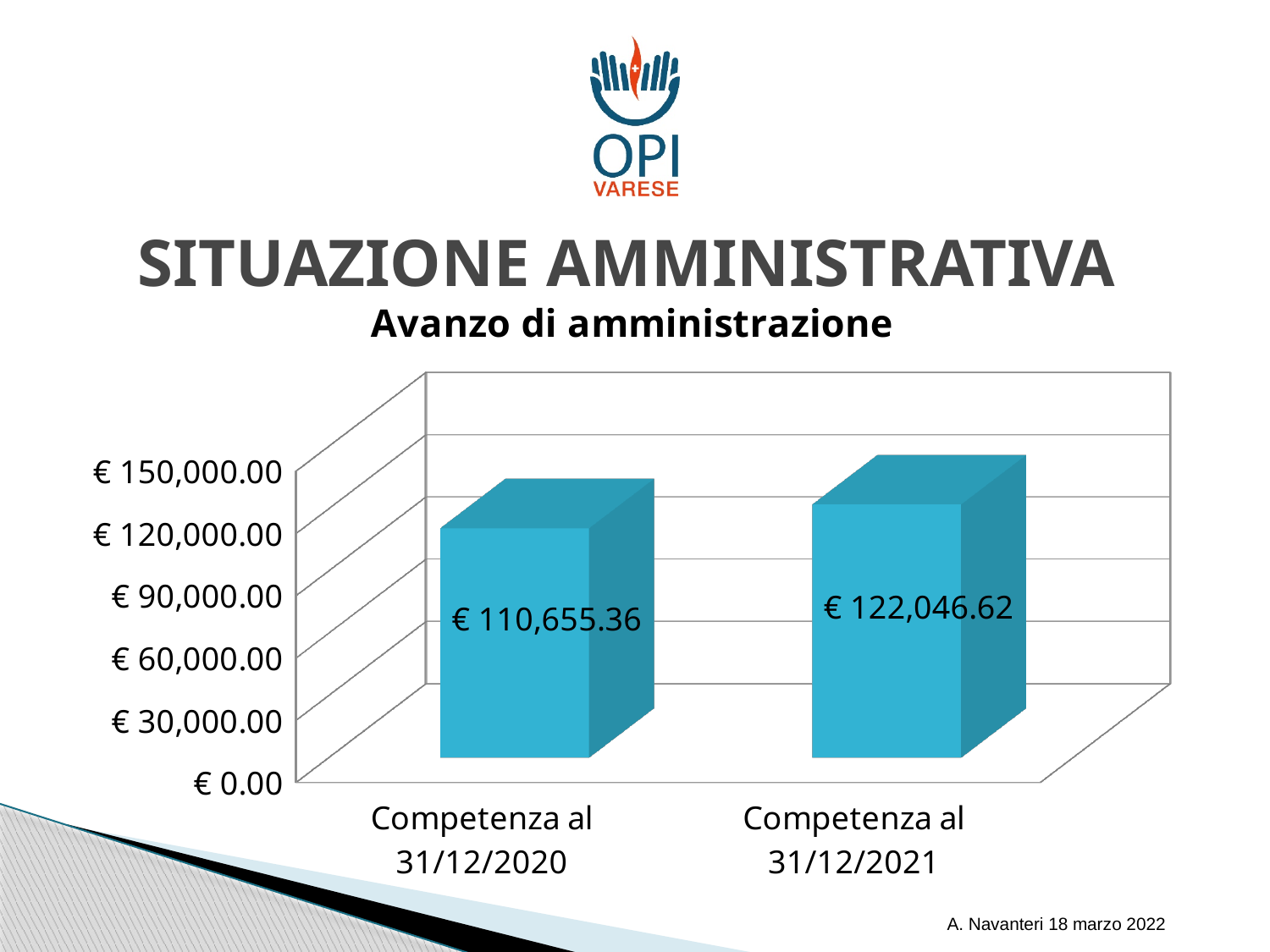
What is the title of the chart? Avanzo di amministrazione Is the value for Competenza al 31/12/2021 greater or less than € 150,000.00? less Is the value for Competenza al 31/12/2020 greater or less than € 90,000.00? greater How many categories are shown in the chart? 2 Which is larger, the value for Competenza al 31/12/2020 or the value for Competenza al 31/12/2021? Competenza al 31/12/2021 Do the values rise or fall from Competenza al 31/12/2020 to Competenza al 31/12/2021? rise What is the value for Competenza al 31/12/2021? € 122,046.62 Which category has the highest value? Competenza al 31/12/2021 Which category has the lowest value? Competenza al 31/12/2020 What is the difference between the value for Competenza al 31/12/2021 and the value for Competenza al 31/12/2020? € 11,391.26 What kind of chart is shown on the slide? bar chart What is the value for Competenza al 31/12/2020? € 110,655.36